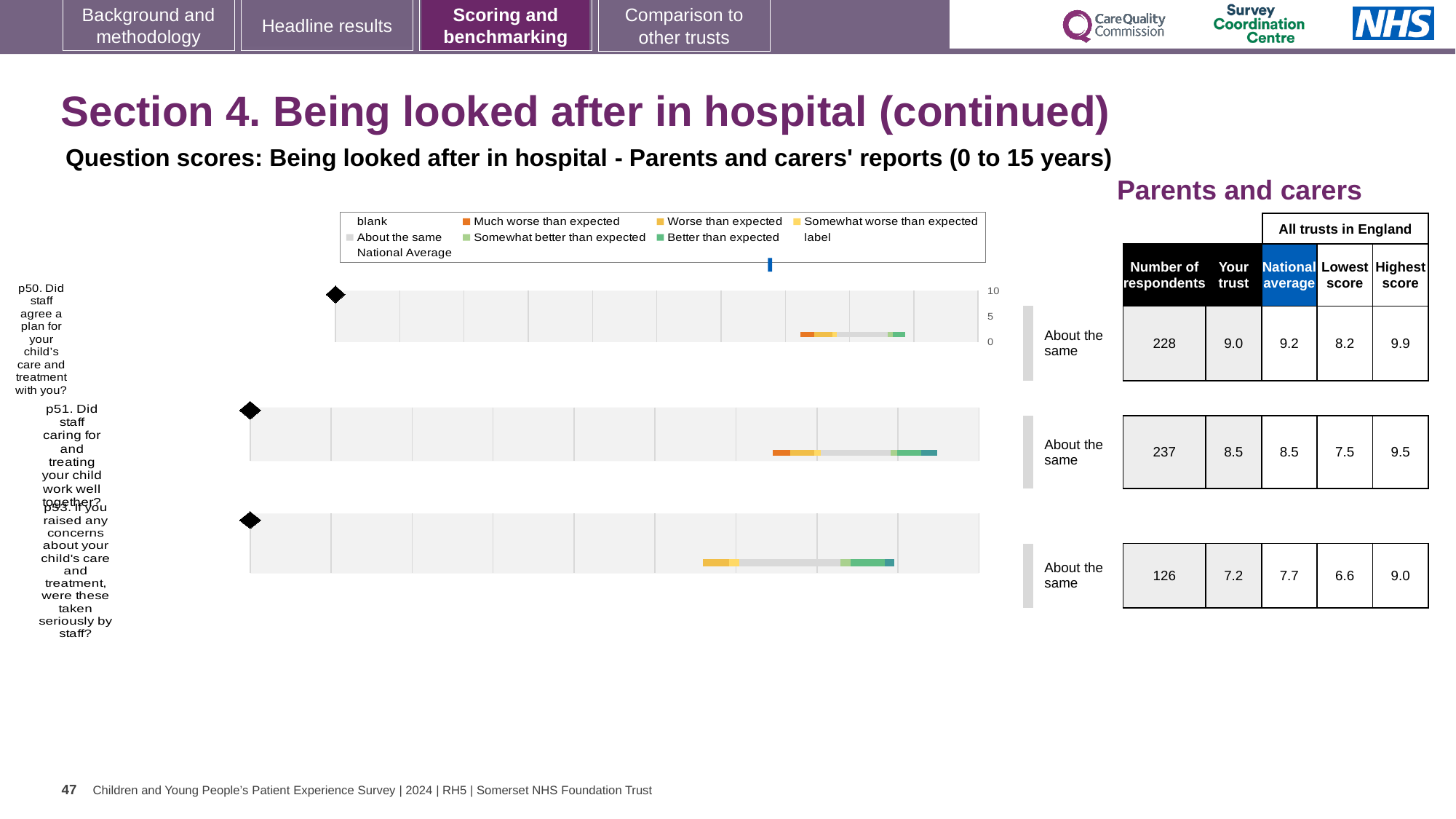
For p50, which is larger: the 'Your trust' score or the National average? National average What is the 'Your trust' score for p50 (Did staff agree a plan for your child's care and treatment with you?)? 9.0 What is the Highest score among all trusts in England for p53? 9.0 Which question has the lowest number of respondents? p53 What is the National average score for p51 (Did staff caring for and treating your child work well together?)? 8.5 How many respondents are shown for p53 (If you raised any concerns about your child's care and treatment, were these taken seriously by staff?)? 126 For p53, what is the difference between the National average (7.7) and the 'Your trust' score (7.2)? 0.5 What kind of chart is used to show the question scores on this slide? bar chart What colour does the legend use for 'Much worse than expected'? orange What benchmark category is shown next to each of the three question charts? About the same How many questions (p50, p51, p53) are plotted on the slide? 3 Which question has the highest 'Your trust' score? p50